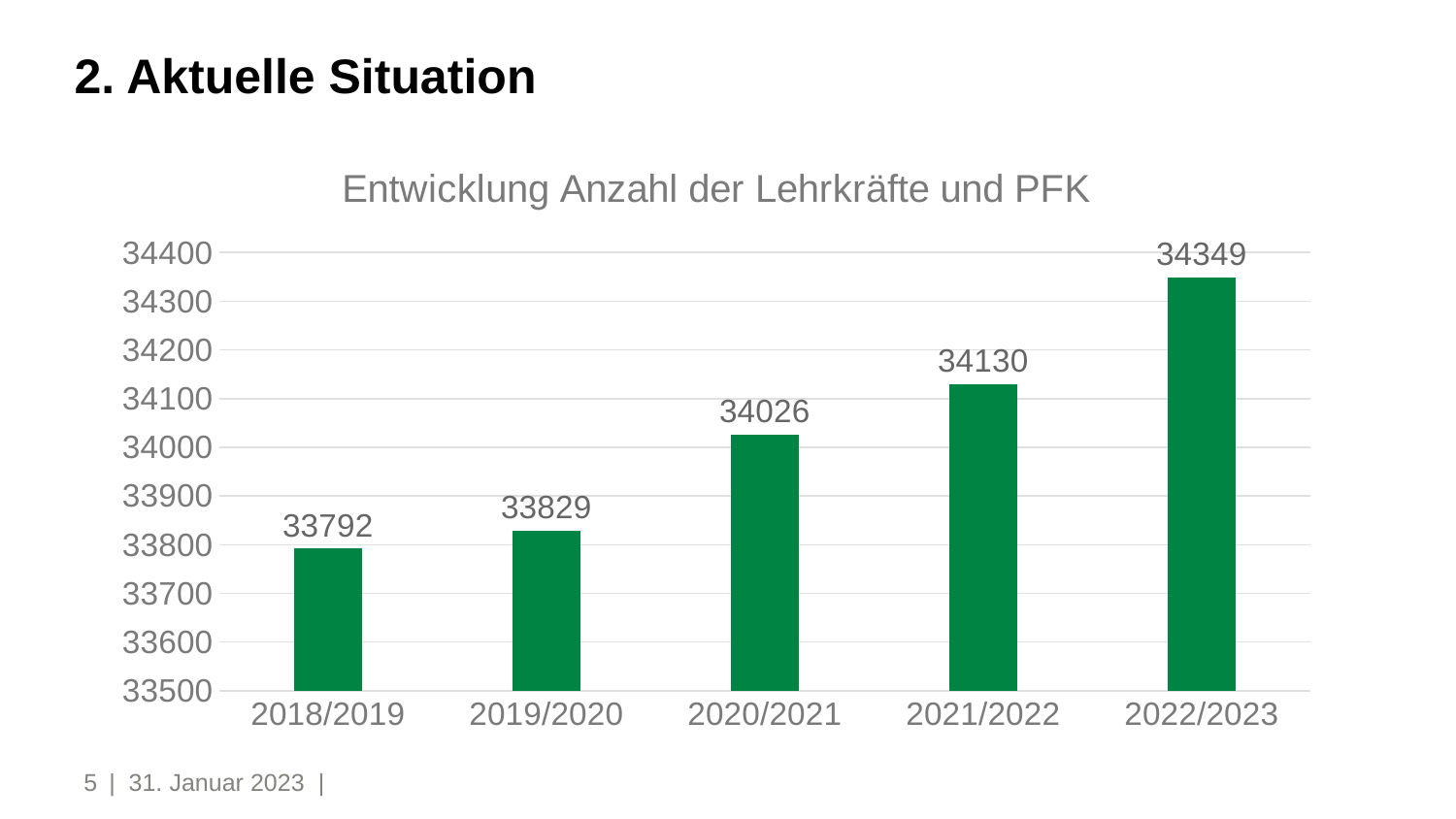
What is the value for 2022/2023? 34349 Which school year has the highest value? 2022/2023 Is the value for 2019/2020 greater or less than 33900? less What is the difference between the values for 2021/2022 and 2020/2021? 104 What kind of chart is shown on the slide? bar chart Do the values rise or fall from 2018/2019 to 2022/2023? rise Which is larger, the value for 2019/2020 or the value for 2021/2022? 2021/2022 What is the difference between the values for 2022/2023 and 2018/2019? 557 What is the value for 2018/2019? 33792 What is the value for 2020/2021? 34026 Which school year has the lowest value? 2018/2019 How many school years are shown on the x axis? 5